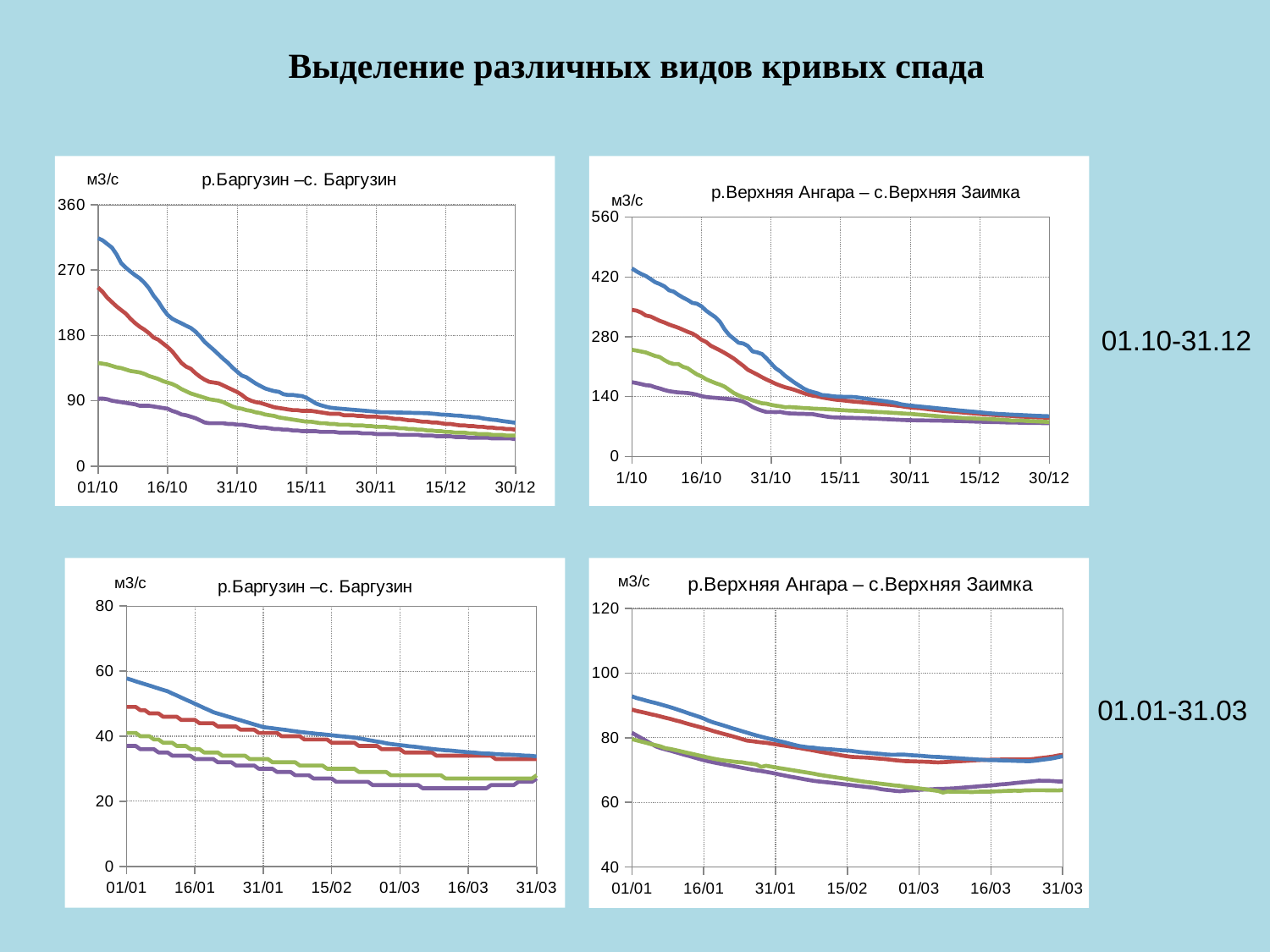
In the bottom-left chart (р.Баргузин –с. Баргузин, 01.01-31.03), is the value of the blue line at 01/01 greater or less than 40? greater In the top-left chart (р.Баргузин –с. Баргузин, 01.10-31.12), do the values rise or fall from 01/10 to 30/12? fall In the bottom-left chart (р.Баргузин –с. Баргузин, 01.01-31.03), is the value of the purple line at 31/03 greater or less than 40? less In the bottom-right chart (р.Верхняя Ангара – с.Верхняя Заимка, 01.01-31.03), which line is lower at 01/01, the blue line or the green line? the green line In the top-left chart (р.Баргузин –с. Баргузин, 01.10-31.12), is the value of the blue line at 01/10 greater or less than 270? greater In the top-right chart (р.Верхняя Ангара – с.Верхняя Заимка, 01.10-31.12), which line is higher at 1/10, the blue line or the purple line? the blue line What kind of chart is the top-left chart titled 'р.Баргузин –с. Баргузин'? line chart What is the highest value shown on the y axis of the top-right chart (р.Верхняя Ангара – с.Верхняя Заимка, 01.10-31.12)? 560 In the top-left chart (р.Баргузин –с. Баргузин, 01.10-31.12), how many lines are plotted? 4 What unit is shown on the y axis of the charts on the slide? м3/с